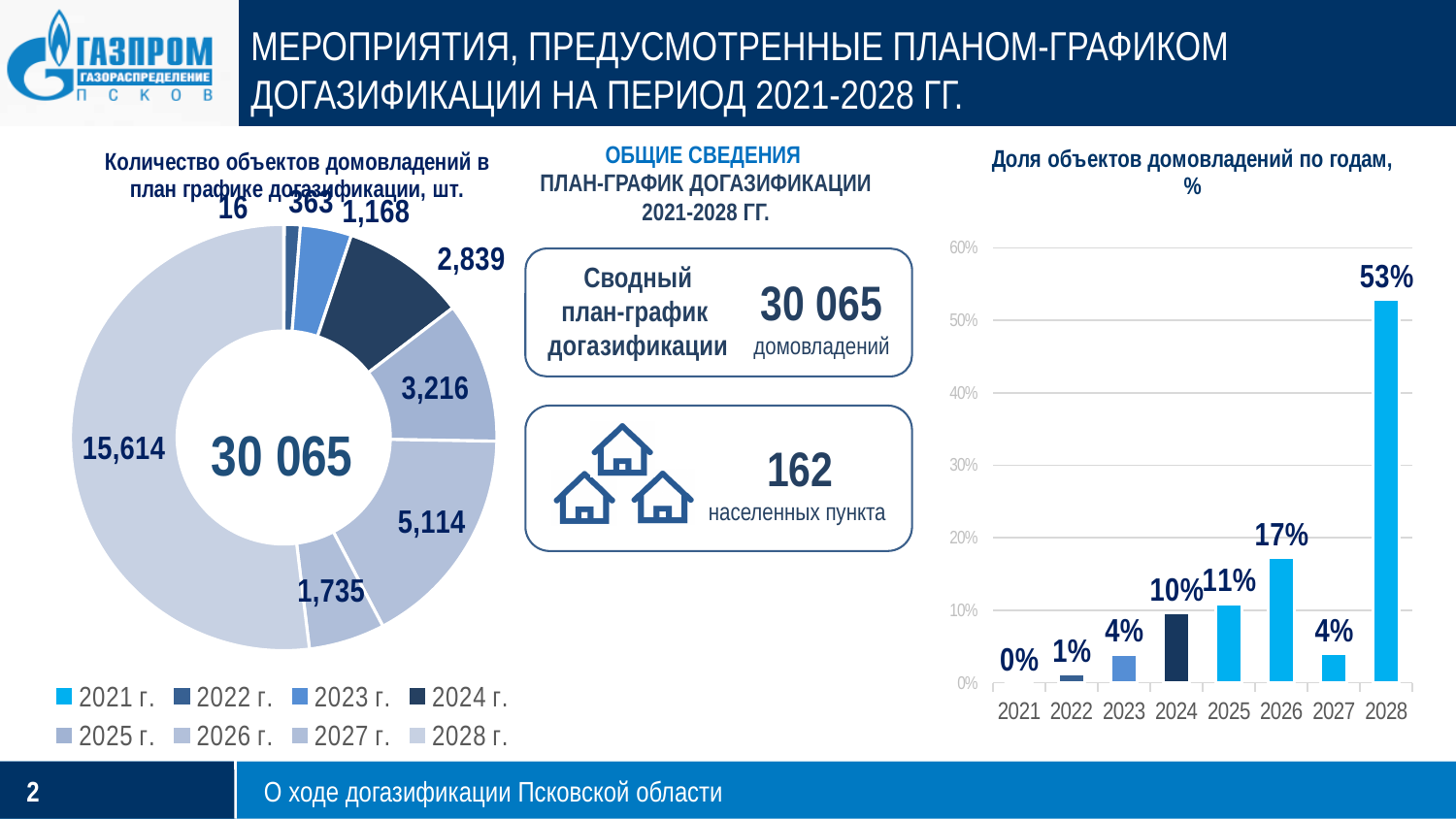
In the doughnut chart 'Количество объектов домовладений в план графике догазификации, шт.', what is the value for 2026 г.? 5,114 In the bar chart 'Доля объектов домовладений по годам, %', what is the value for 2028? 53% In the doughnut chart 'Количество объектов домовладений в план графике догазификации, шт.', what is the value for 2028 г.? 15,614 In the bar chart 'Доля объектов домовладений по годам, %', what is the value for 2026? 17% In the bar chart 'Доля объектов домовладений по годам, %', what is the difference between the values for 2028 and 2026? 36% How many entries does the legend of the doughnut chart on the left list? 8 In the bar chart 'Доля объектов домовладений по годам, %', how many years are shown on the x axis? 8 In the bar chart 'Доля объектов домовладений по годам, %', which year has the lowest share? 2021 What kind of chart is the chart on the right of the slide, 'Доля объектов домовладений по годам, %'? Bar chart In the doughnut chart 'Количество объектов домовладений в план графике догазификации, шт.', what total is shown in the centre? 30 065 In the bar chart 'Доля объектов домовладений по годам, %', which year has the highest share? 2028 In the bar chart 'Доля объектов домовладений по годам, %', which is larger, the value for 2024 or the value for 2025? 2025